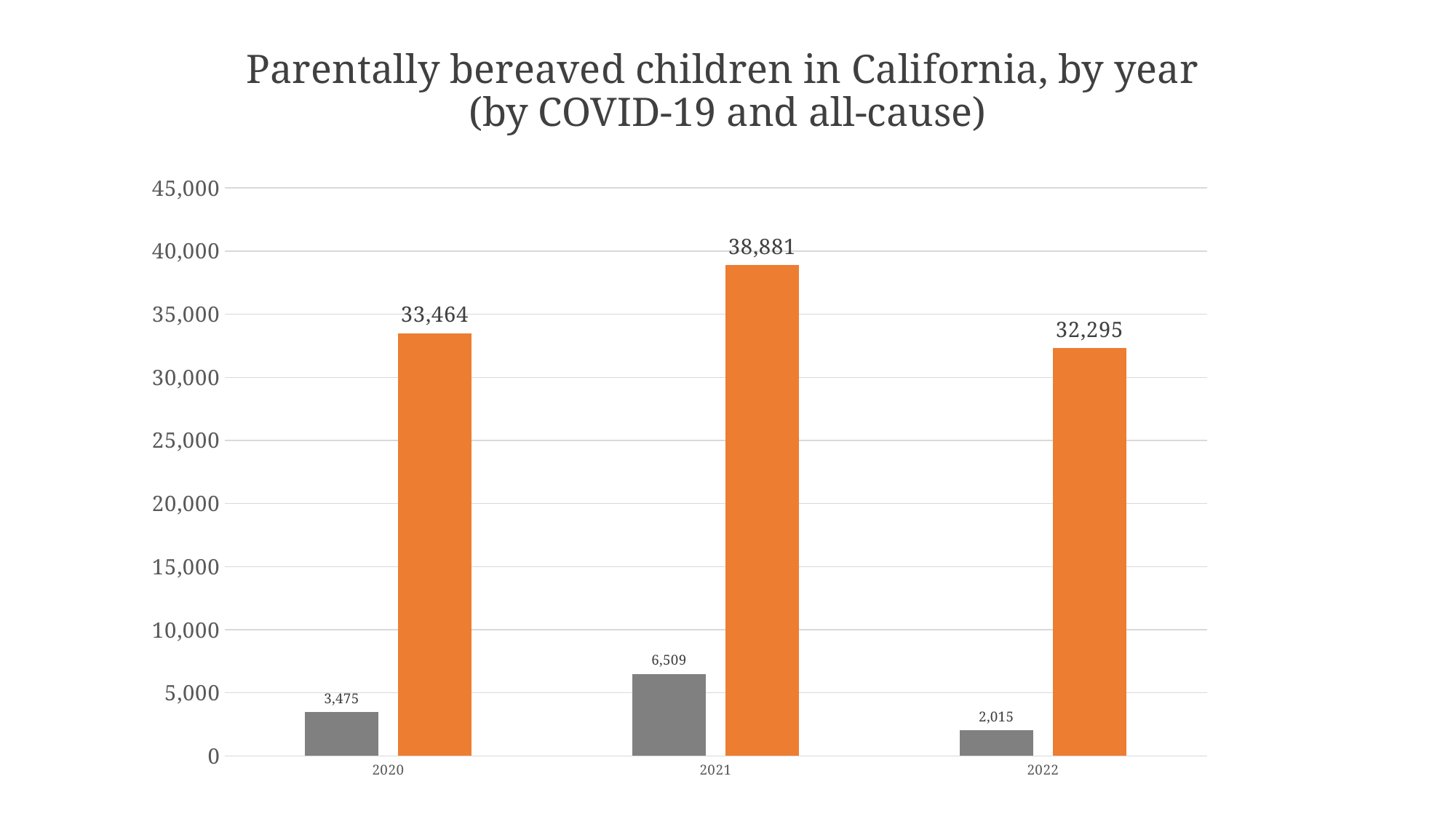
How many years are shown on the x axis? 3 Which year has the larger orange bar, 2020 or 2022? 2020 What is the value of the orange bar for 2021? 38,881 What is the difference between the orange bar values for 2021 and 2020? 5,417 Is the value of the gray bar for 2021 greater or less than 5,000? greater Do the orange bar values rise or fall from 2021 to 2022? Fall What kind of chart is shown on the slide? Bar chart What is the value of the gray bar for 2020? 3,475 Which year has the lowest gray bar? 2022 Which year has the highest orange bar? 2021 What is the difference between the gray bar values for 2021 and 2022? 4,494 What is the value of the gray bar for 2022? 2,015